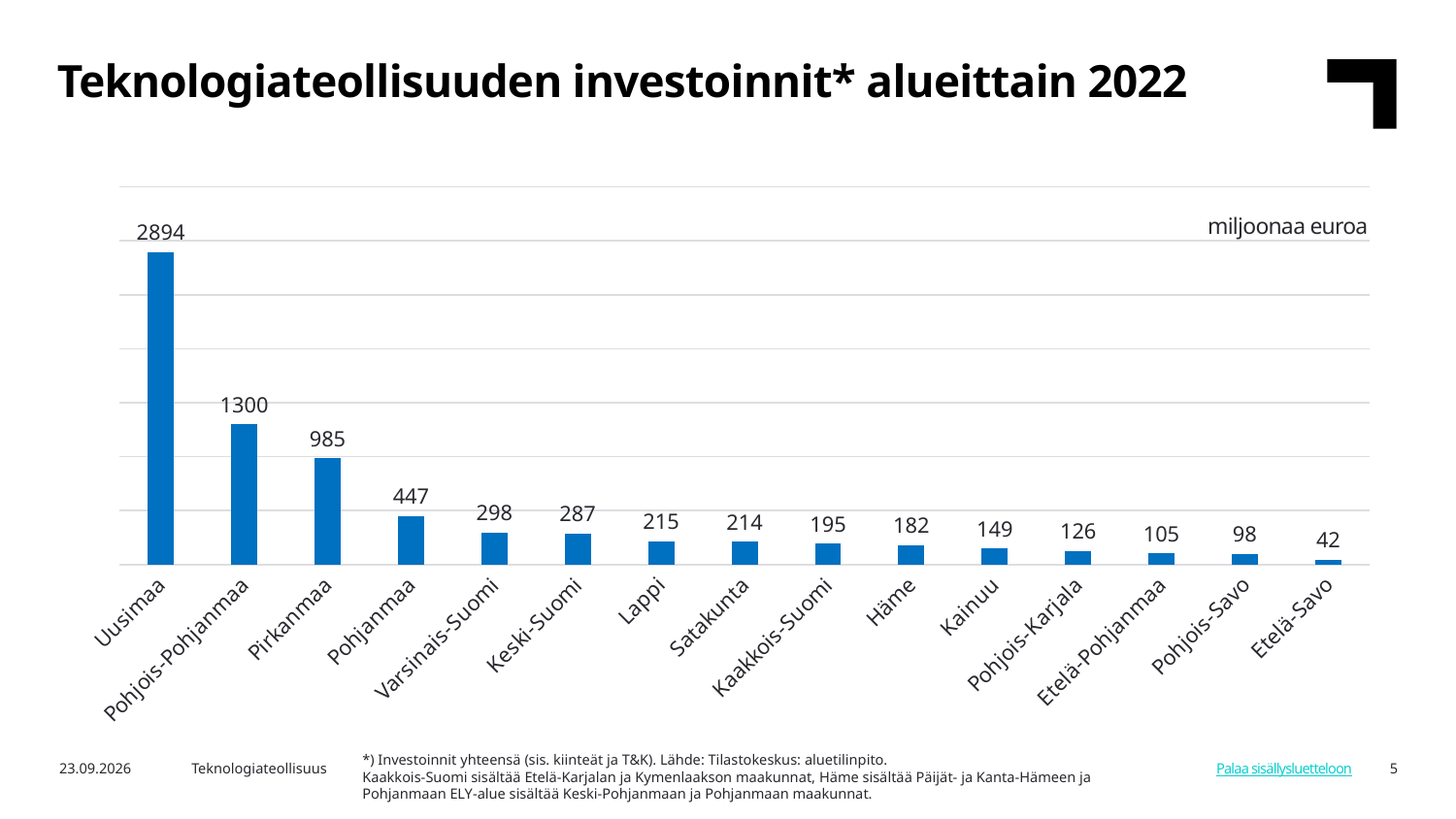
What is the value for Kaakkois-Suomi? 195 What is the value for Pirkanmaa? 985 Which region has the lowest value? Etelä-Savo Which is larger, the value for Pohjanmaa or the value for Häme? Pohjanmaa How many regions are shown in the chart? 15 What is the difference between the values for Uusimaa and Pohjois-Pohjanmaa? 1594 What kind of chart is shown on the slide? Bar chart What is the difference between the values for Pohjanmaa and Varsinais-Suomi? 149 What is the value for Pohjois-Savo? 98 What unit is stated for the values in the chart? miljoonaa euroa What is the value for Uusimaa? 2894 Which region has the highest value? Uusimaa